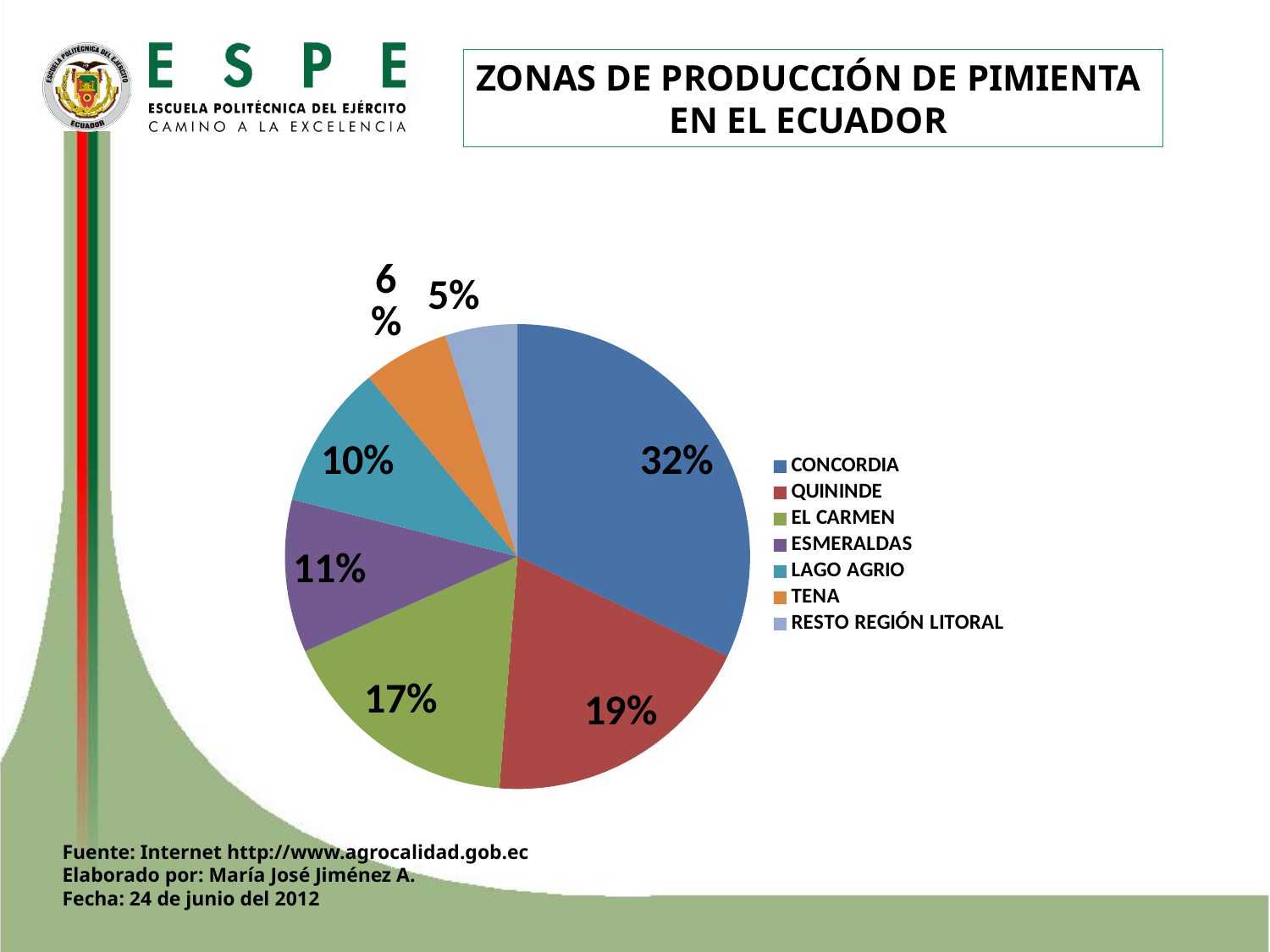
What is the title of the chart? ZONAS DE PRODUCCIÓN DE PIMIENTA EN EL ECUADOR What share of the pie does CONCORDIA have? 32% Which zone has the largest slice of the pie? CONCORDIA What share of the pie does RESTO REGIÓN LITORAL have? 5% Which zone has the smallest slice of the pie? RESTO REGIÓN LITORAL How many zones (slices) are shown in the pie chart? 7 What is the difference in percentage points between CONCORDIA and QUININDE? 13 What kind of chart is shown on the slide? Pie chart What share of the pie does ESMERALDAS have? 11%